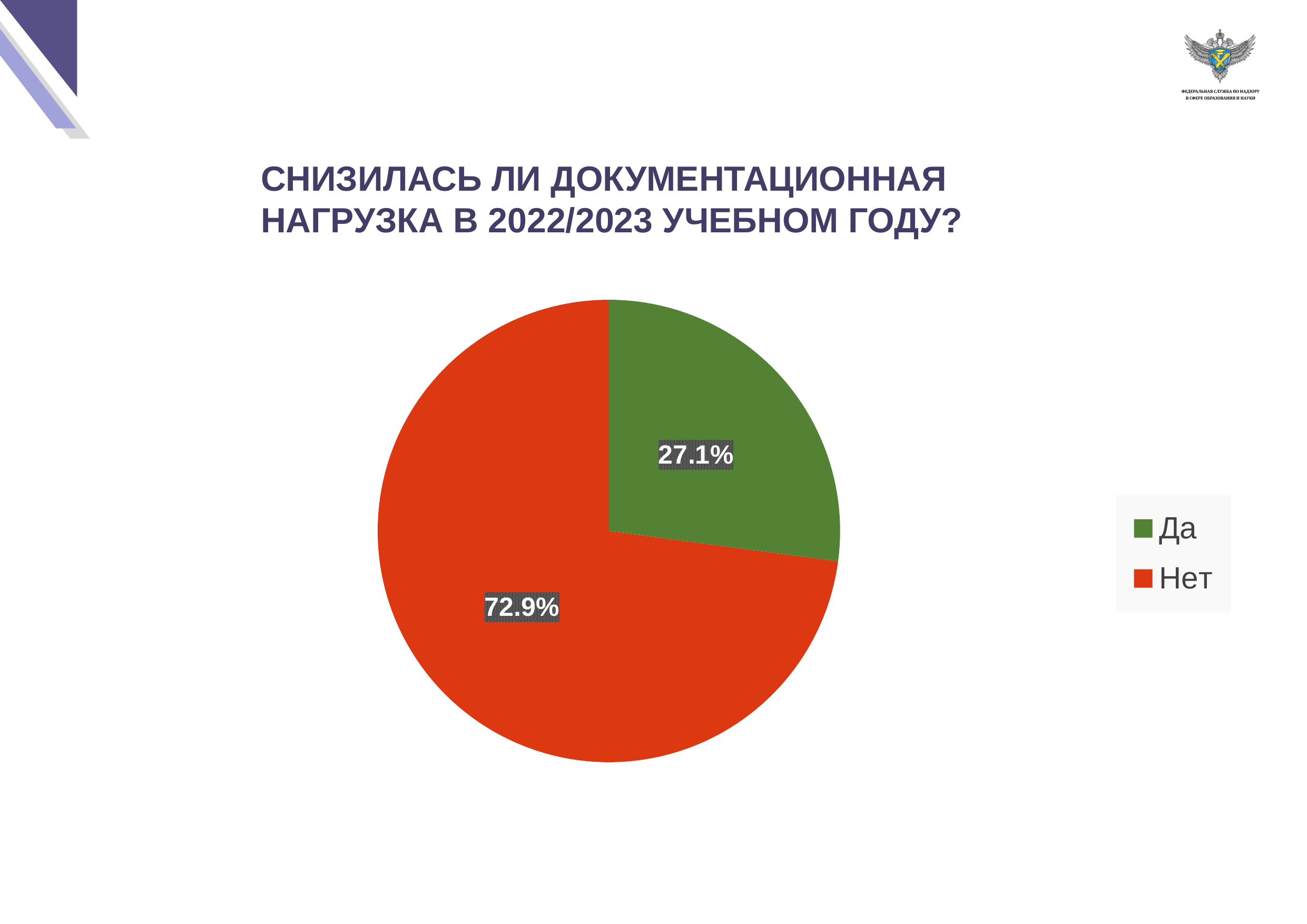
What percentage of respondents answered "Да"? 27.1% What share of the pie does the "Да" slice represent? 27.1% What colour is the "Нет" slice? Red Which slice is larger, "Да" or "Нет"? Нет Which answer has the smallest share of the pie? Да What is the difference in percentage points between the "Нет" and "Да" slices? 45.8 How many slices does the pie chart have? 2 Which answer has the largest share of the pie? Нет What kind of chart is shown on the slide? Pie chart How many entries does the legend list? 2 What colour is the "Да" slice? Green What percentage of respondents answered "Нет"? 72.9%